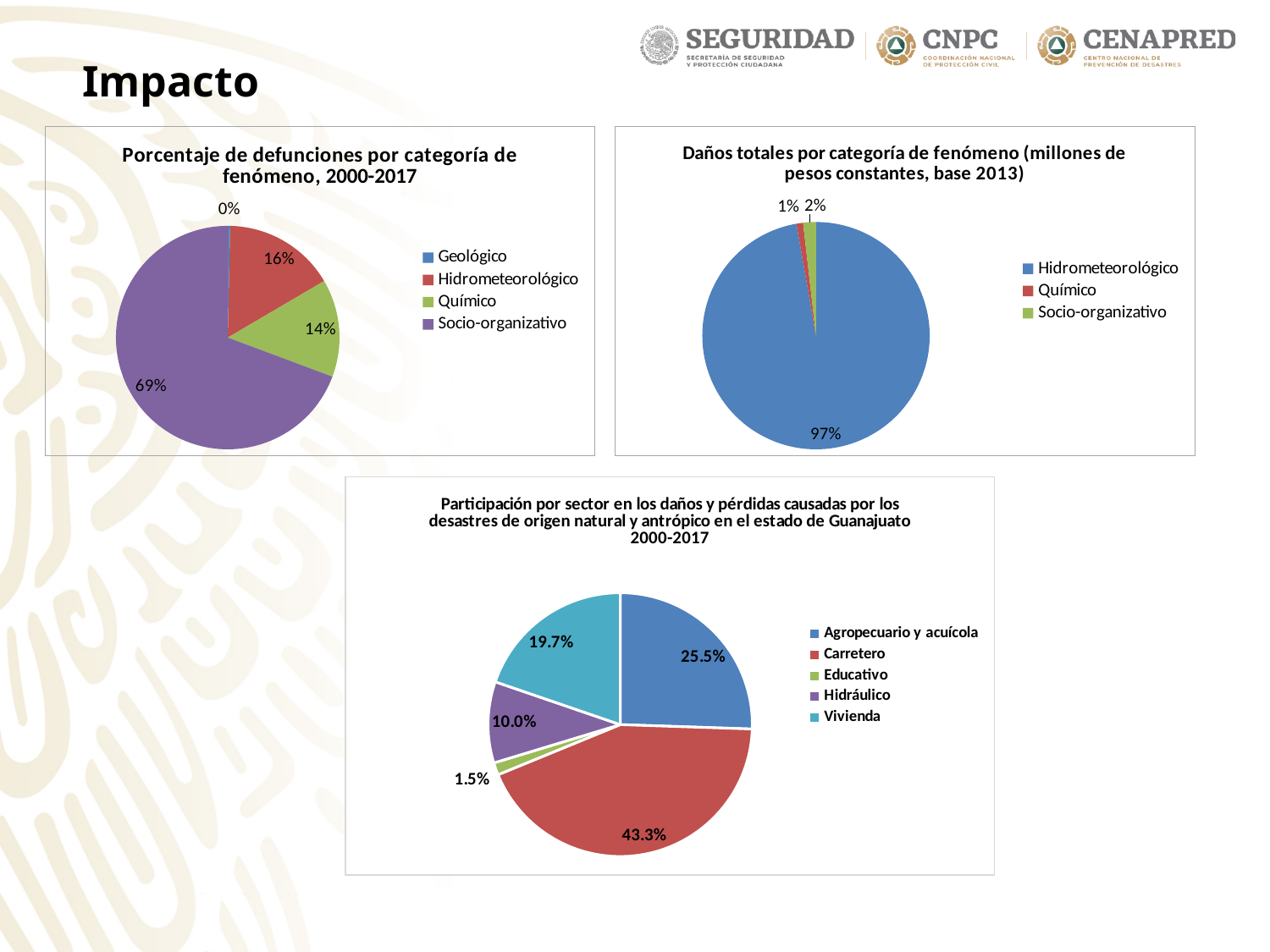
In the top-left chart (Porcentaje de defunciones por categoría de fenómeno, 2000-2017), what is the difference in percentage points between Hidrometeorológico and Químico? 2 In the top-right chart (Daños totales por categoría de fenómeno), which category has the largest share? Hidrometeorológico In the top-left chart (Porcentaje de defunciones por categoría de fenómeno, 2000-2017), how many categories does the legend list? 4 In the top-left chart (Porcentaje de defunciones por categoría de fenómeno, 2000-2017), what share of deaths is attributed to Socio-organizativo? 69% In the top-right chart (Daños totales por categoría de fenómeno), what share is attributed to Hidrometeorológico? 97% In the top-left chart (Porcentaje de defunciones por categoría de fenómeno, 2000-2017), what percentage is shown for Hidrometeorológico? 16% What type of chart is the bottom chart (Participación por sector en los daños y pérdidas)? Pie chart In the top-right chart (Daños totales por categoría de fenómeno), which is larger, Químico or Socio-organizativo? Socio-organizativo In the bottom chart (Participación por sector en los daños y pérdidas), which sector has the smallest share? Educativo In the top-left chart (Porcentaje de defunciones por categoría de fenómeno, 2000-2017), which category has the smallest share? Geológico In the bottom chart (Participación por sector en los daños y pérdidas), what is the difference in percentage points between Agropecuario y acuícola and Vivienda? 5.8 In the bottom chart (Participación por sector en los daños y pérdidas), what share corresponds to Carretero? 43.3%